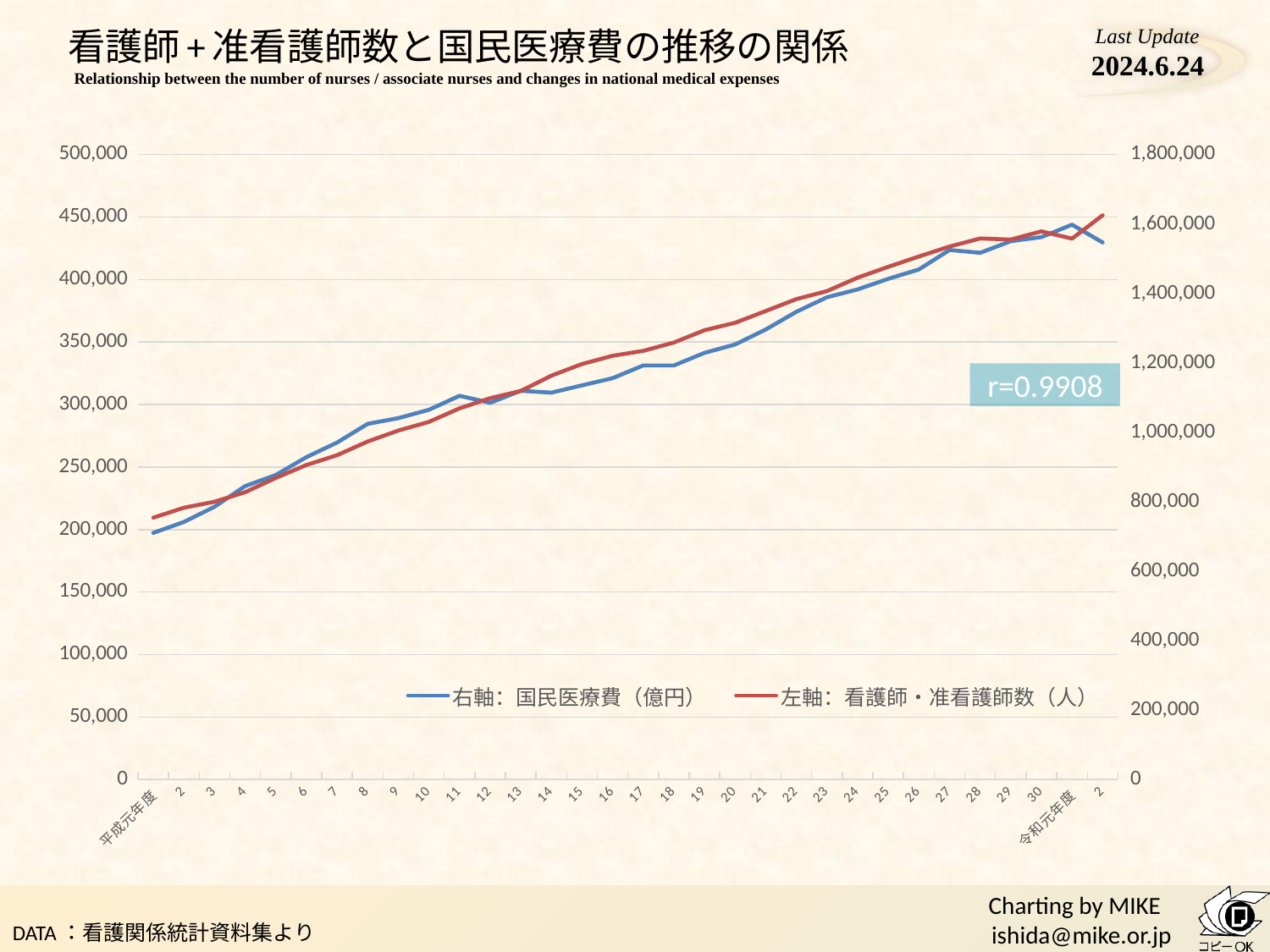
Which series is plotted against the left axis according to the legend? 左軸：看護師・准看護師数（人） Do the values of the 看護師・准看護師数 series generally rise or fall from 平成元年度 to 令和2年度? rise Is the value of the 国民医療費 series (right axis) at 平成元年度 greater or less than 800,000? less Do the values of the 国民医療費 series generally rise or fall across the x axis? rise How many fiscal-year points are plotted along the x axis? 32 What correlation coefficient is printed on the chart? r=0.9908 What kind of chart is shown on the slide? line chart How many series does the legend list? 2 At which fiscal year is the 看護師・准看護師数 series at its lowest? 平成元年度 Is the value of the 看護師・准看護師数 series (left axis) at 令和2年度 greater or less than 400,000? greater